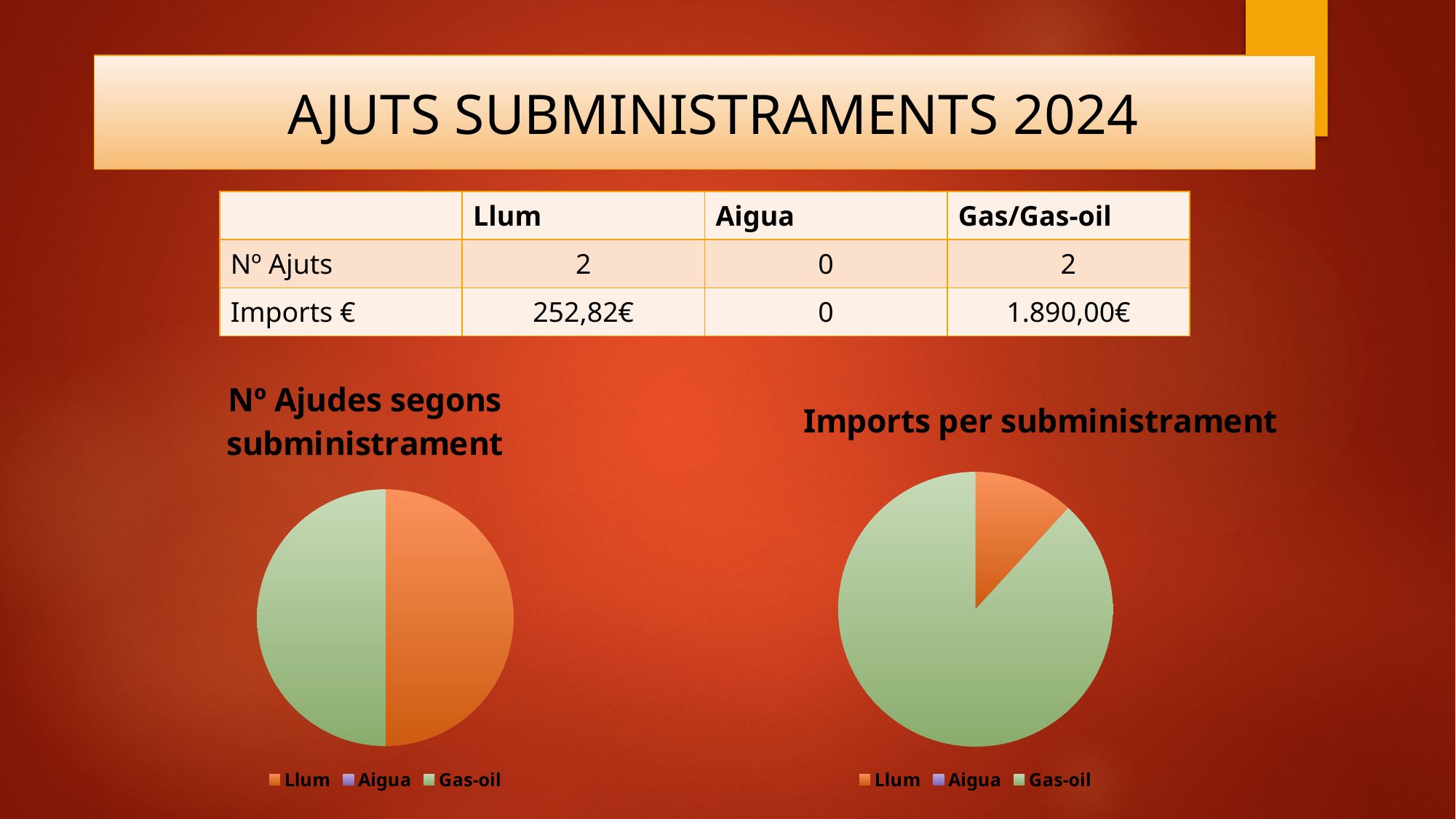
In the "Imports per subministrament" chart, which category has the largest slice? Gas-oil How many entries does the legend of the "Imports per subministrament" chart list? 3 In the "Nº Ajudes segons subministrament" chart, what is the value for Llum? 2 In the "Imports per subministrament" chart, what is the value for Gas-oil? 1.890,00€ In the "Nº Ajudes segons subministrament" chart, what is the value for Aigua? 0 What type of chart is "Imports per subministrament"? pie chart What type of chart is "Nº Ajudes segons subministrament"? pie chart What colour is the Gas-oil slice in the "Nº Ajudes segons subministrament" chart? green In the "Imports per subministrament" chart, what is the value for Llum? 252,82€ In the "Imports per subministrament" chart, which of Llum or Gas-oil has the larger slice? Gas-oil In the "Nº Ajudes segons subministrament" chart, what share of the pie does Llum take? 50% In the "Imports per subministrament" chart, which category has the smallest slice? Aigua